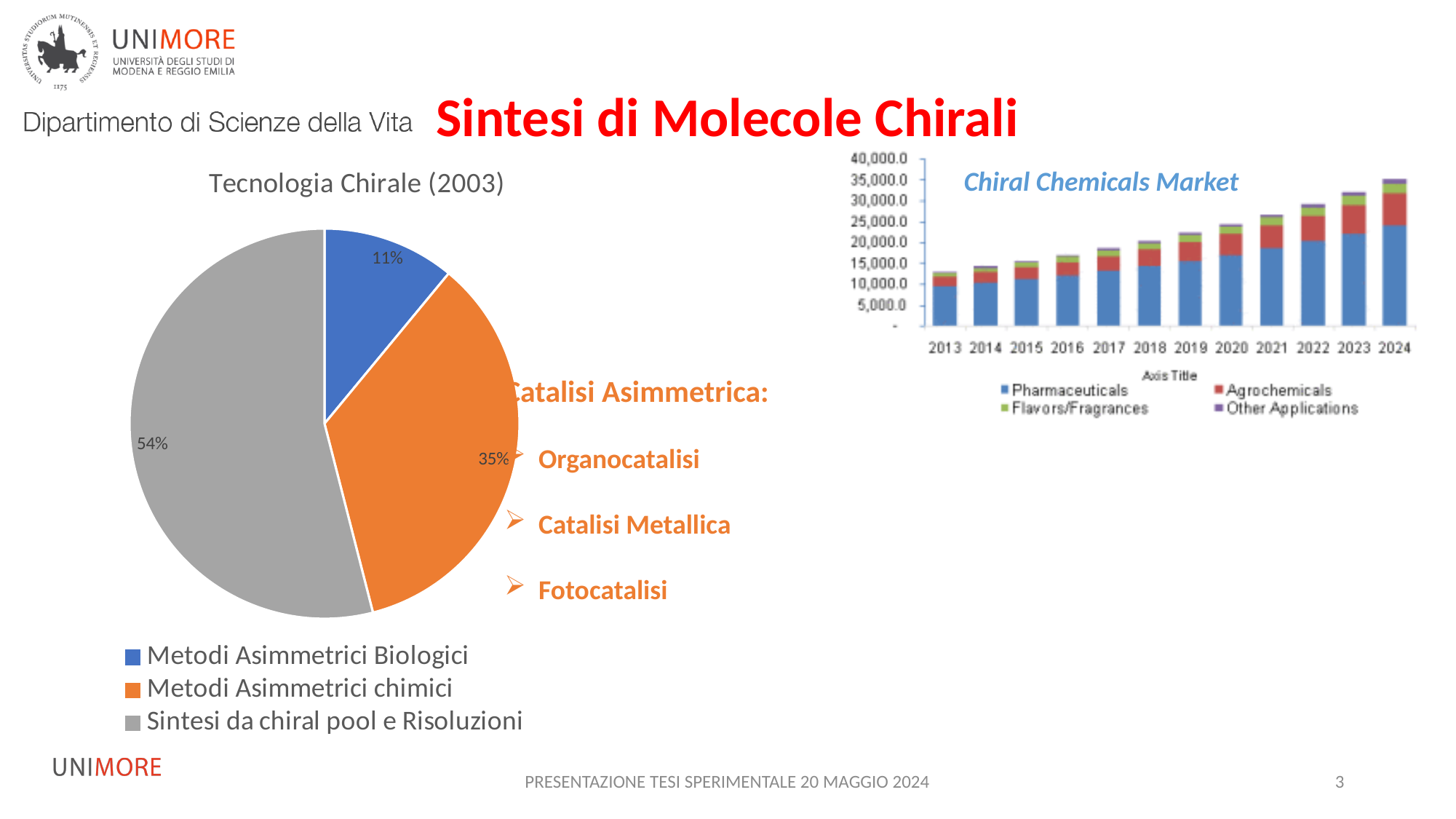
How many slices does the 'Tecnologia Chirale (2003)' pie chart have? 3 In the 'Chiral Chemicals Market' chart, do the total bar heights rise or fall from 2013 to 2024? Rise In the 'Tecnologia Chirale (2003)' pie chart, what share is shown for Sintesi da chiral pool e Risoluzioni? 54% In the 'Tecnologia Chirale (2003)' pie chart, what share is shown for Metodi Asimmetrici Biologici? 11% How many series does the legend of the 'Chiral Chemicals Market' chart list? 4 In the 'Tecnologia Chirale (2003)' pie chart, what share is shown for Metodi Asimmetrici chimici? 35% In the 'Chiral Chemicals Market' chart, is the total for 2024 greater or less than 30,000.0? greater In the 'Tecnologia Chirale (2003)' pie chart, which category has the smallest slice? Metodi Asimmetrici Biologici What type of chart is the 'Chiral Chemicals Market' chart? Stacked bar chart In the 'Tecnologia Chirale (2003)' pie chart, which category has the largest slice? Sintesi da chiral pool e Risoluzioni In the 'Tecnologia Chirale (2003)' pie chart, what is the difference in percentage points between Sintesi da chiral pool e Risoluzioni and Metodi Asimmetrici chimici? 19 percentage points How many years are shown on the x axis of the 'Chiral Chemicals Market' chart? 12